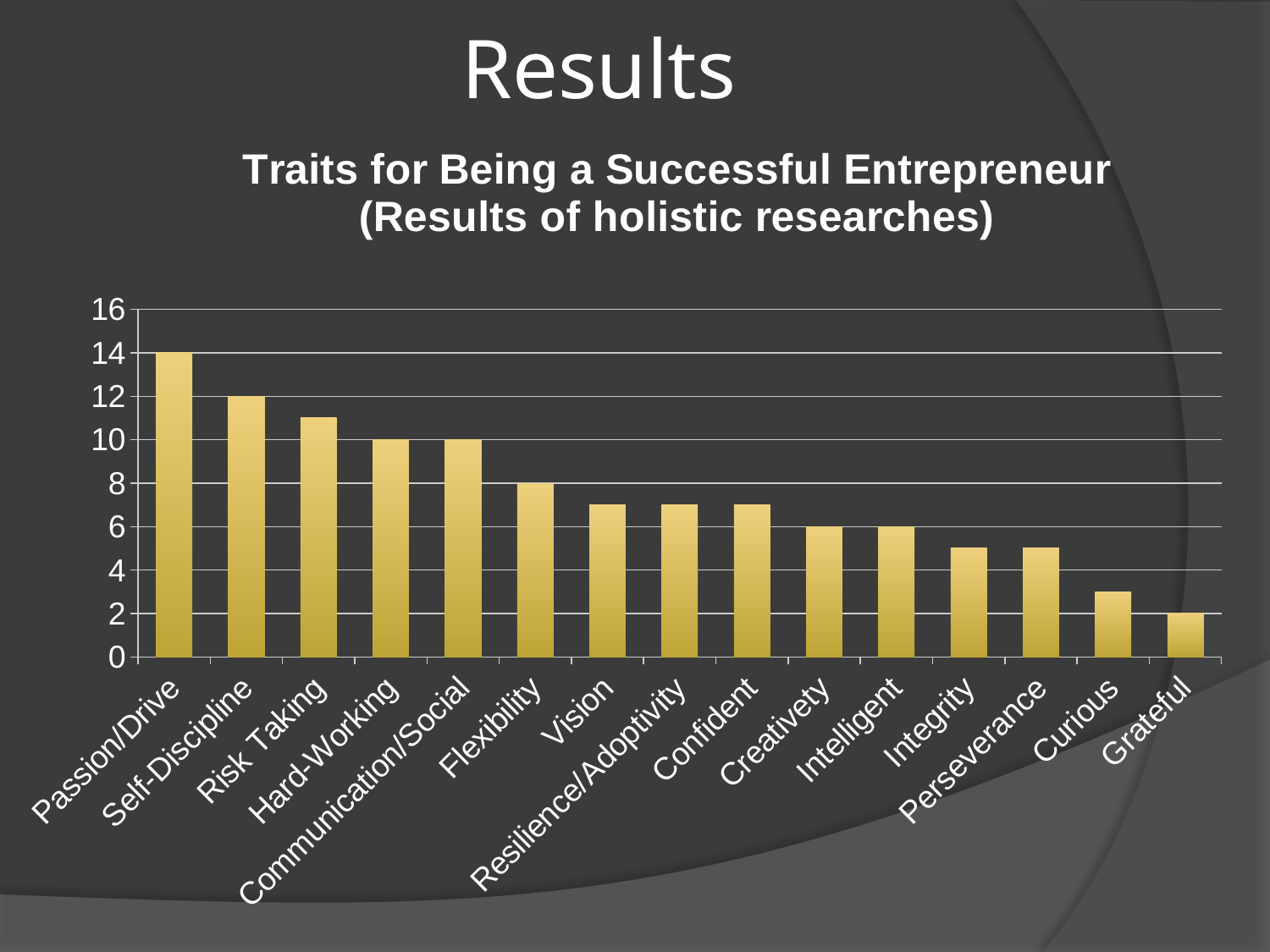
What is the value for Grateful? 2 What is the value for Self-Discipline? 12 What is the value for Passion/Drive? 14 Which trait has the highest value in the chart? Passion/Drive What is the difference between the values for Passion/Drive and Self-Discipline? 2 Is the value for Curious greater or less than 4? less How many traits are shown on the x axis of the chart? 15 What is the value for Flexibility? 8 Which trait has the lowest value in the chart? Grateful Is the value for Risk Taking greater or less than 10? greater Which has a larger value, Hard-Working or Integrity? Hard-Working What type of chart is shown on the slide? Bar chart